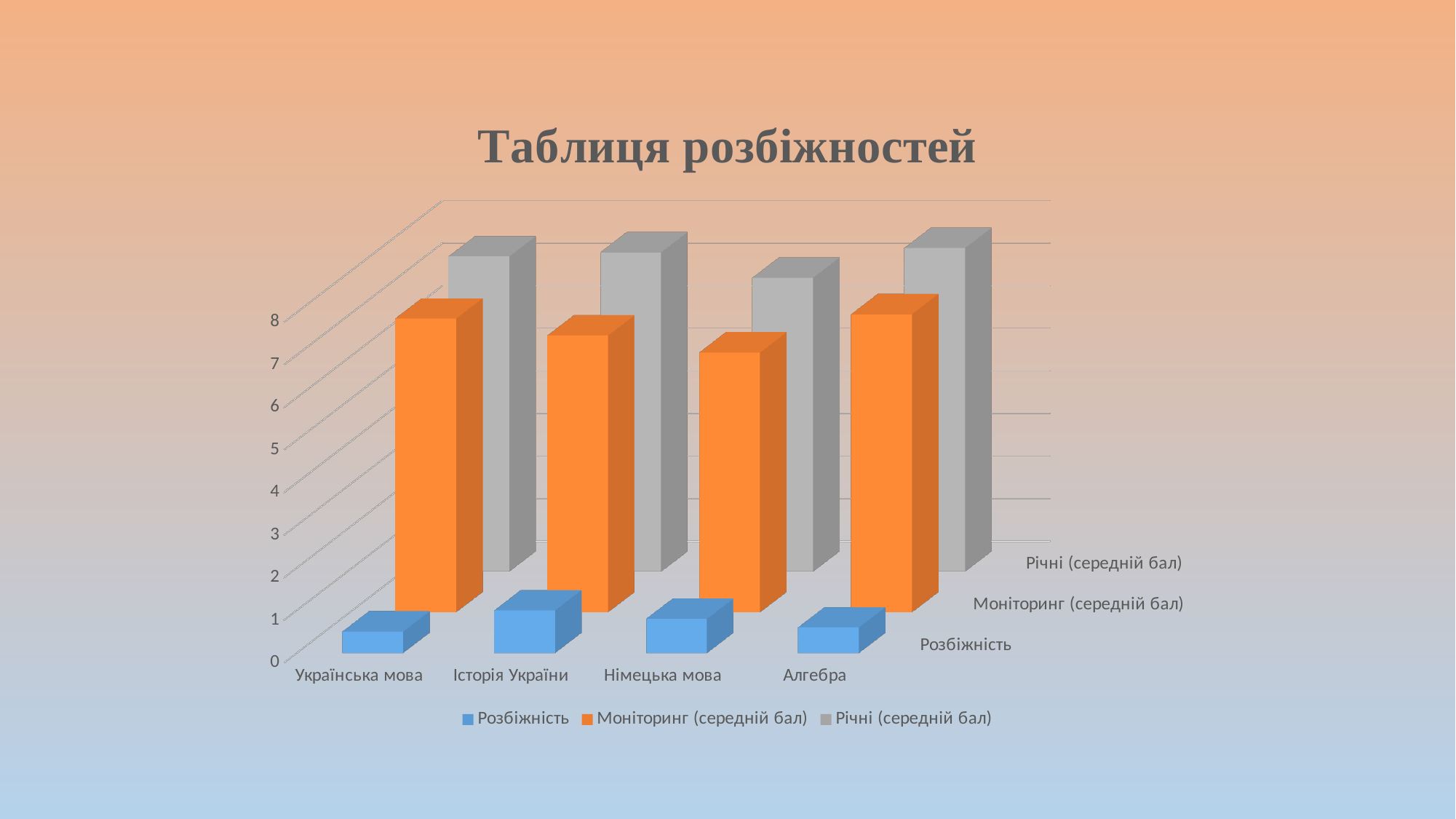
What is the title of the chart? Таблиця розбіжностей Which series is shown in orange in the chart? Моніторинг (середній бал) Which category has the lowest value for the Розбіжність series? Українська мова Is the Розбіжність value for Українська мова greater or less than 1? less How many categories are shown on the x axis of the chart? 4 Is the Моніторинг (середній бал) value for Німецька мова greater or less than 4? greater What kind of chart is shown on the slide? bar chart For Алгебра, which is larger: the Моніторинг (середній бал) value or the Розбіжність value? Моніторинг (середній бал) Is the Річні (середній бал) value for Німецька мова greater or less than 5? greater Which category has the lowest value for the Річні (середній бал) series? Німецька мова Which category has the lowest value for the Моніторинг (середній бал) series? Німецька мова How many series does the legend list? 3